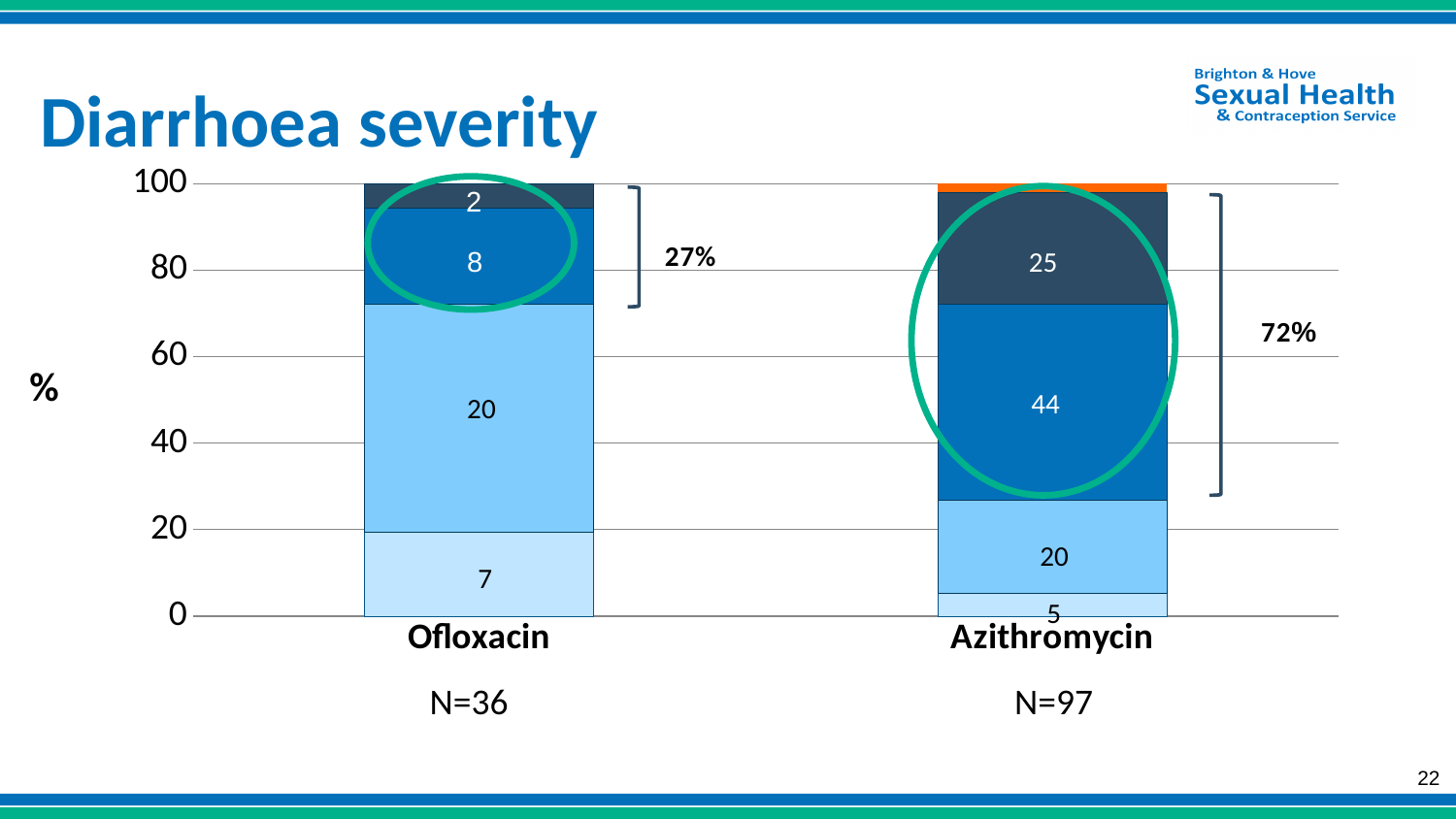
Which bar has the larger bracketed percentage, Ofloxacin or Azithromycin? Azithromycin What percentage is annotated next to the bracket beside the Ofloxacin bar? 27% What type of chart is shown on the slide? Stacked bar chart What is the label of the bottom segment of the Ofloxacin bar? 7 What is the difference between the bracketed percentages for Azithromycin (72%) and Ofloxacin (27%)? 45% How many bars (categories) are plotted in the chart? 2 What is the sample size (N) shown under the Ofloxacin bar? N=36 What is the label of the topmost labelled segment of the Ofloxacin bar? 2 What is the label of the bottom segment of the Azithromycin bar? 5 What is the title of the slide's chart? Diarrhoea severity What is the label of the largest segment of the Azithromycin bar? 44 What percentage is annotated next to the bracket beside the Azithromycin bar? 72%